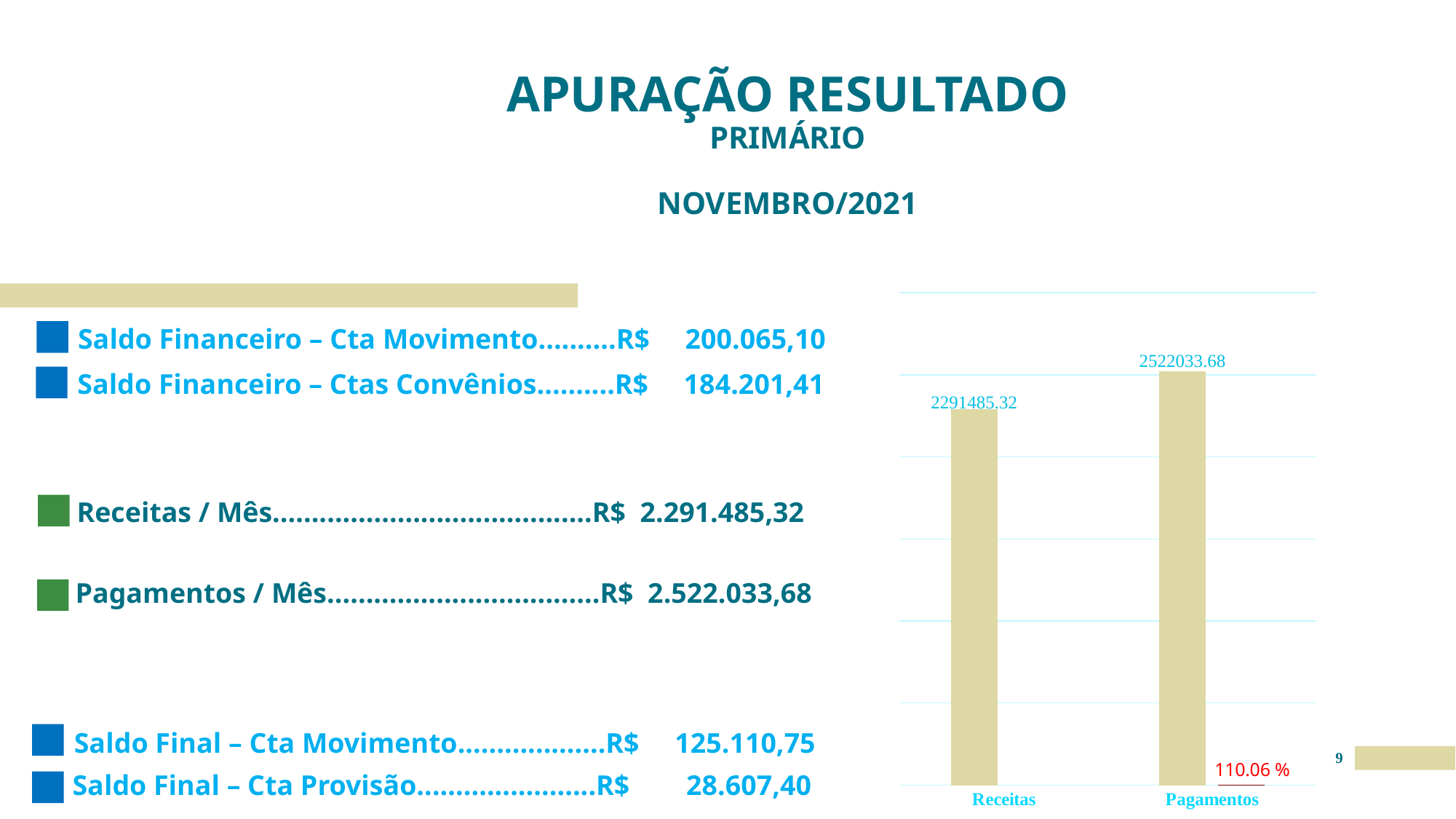
How many bars are plotted in the chart? 2 Which category has the lowest bar in the chart? Receitas What is the value of the Pagamentos bar in the chart? 2522033.68 What kind of chart is shown on the slide? Bar chart Do the values rise or fall from Receitas to Pagamentos in the chart? Rise What is the value of the Receitas bar in the chart? 2291485.32 What is the difference between the Pagamentos and Receitas values in the chart? 230548.36 What are the category labels on the x axis of the chart? Receitas and Pagamentos What percentage is printed in red near the Pagamentos bar? 110.06 % Which is larger in the chart, Receitas or Pagamentos? Pagamentos Which category has the highest bar in the chart? Pagamentos